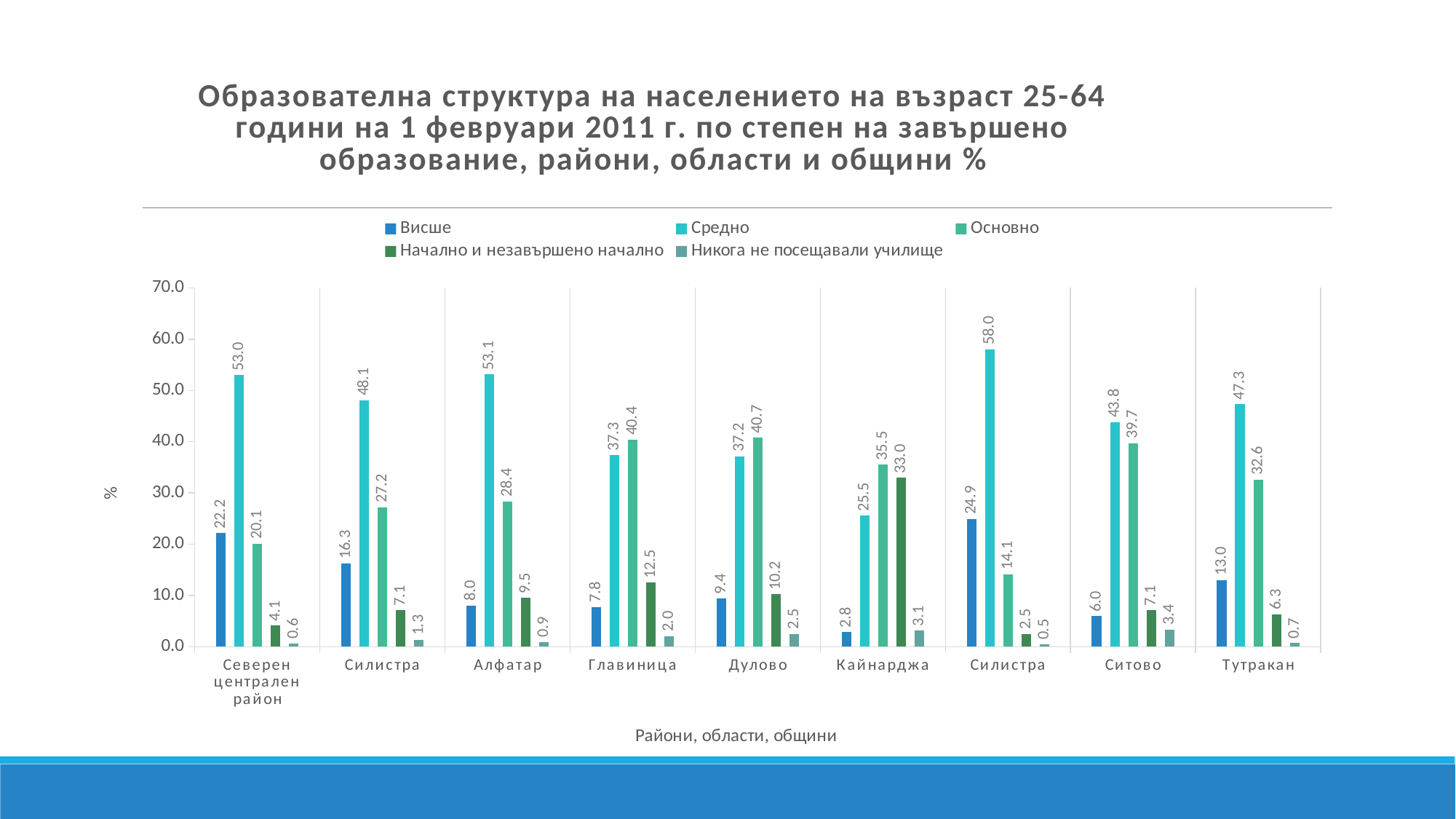
For Главиница, which is larger: the Средно value or the Основно value? Основно What is the value of the Основно series for Кайнарджа? 35.5 Is the Средно value for Ситово greater or less than 40? greater What is the value of the Висше series for Алфатар? 8.0 What is the label of the x axis? Райони, области, общини Which category has the lowest value in the Висше series? Кайнарджа How many categories are shown on the x axis? 9 What is the value of the Никога не посещавали училище series for Ситово? 3.4 Which category has the highest value in the Средно series? Силистра (58.0) How many series does the legend list? 5 For Тутракан, what is the difference between the Средно value and the Основно value? 14.7 What kind of chart is shown on the slide? bar chart